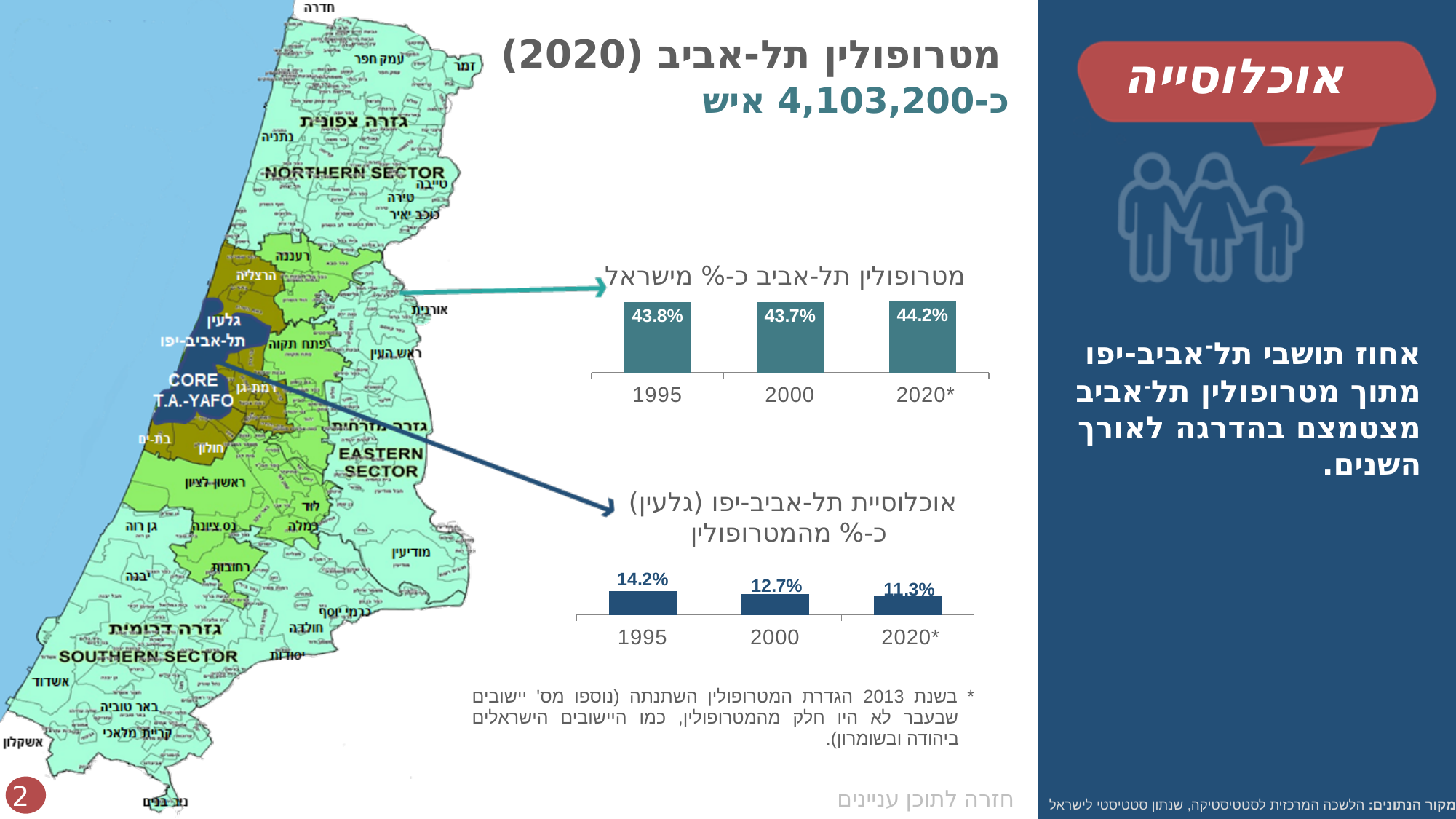
In the bottom chart (Tel Aviv-Yafo core population as % of the metropolitan area), what is the value for 2000? 12.7% In the bottom chart (Tel Aviv-Yafo core population as % of the metropolitan area), what is the difference between the 1995 value and the 2020* value? 2.9% In the bottom chart (Tel Aviv-Yafo core population as % of the metropolitan area), which year has the highest value? 1995 How many bars are shown in the bottom chart (Tel Aviv-Yafo core population as % of the metropolitan area)? 3 In the bottom chart, which is larger: the value for 1995 or the value for 2000? 1995 In the bottom chart (Tel Aviv-Yafo core population as % of the metropolitan area), what is the value for 2020*? 11.3% In the top chart (Tel Aviv metropolitan area as % of Israel), what is the value for 1995? 43.8% In the bottom chart (Tel Aviv-Yafo core population as % of the metropolitan area), do the values rise or fall from 1995 to 2020*? fall In the top chart (Tel Aviv metropolitan area as % of Israel), which year has the lowest value? 2000 What type of chart is the top chart (Tel Aviv metropolitan area as % of Israel)? bar chart In the top chart (Tel Aviv metropolitan area as % of Israel), what is the value for 2020*? 44.2% In the top chart (Tel Aviv metropolitan area as % of Israel), what is the difference between the 2020* value and the 2000 value? 0.5%